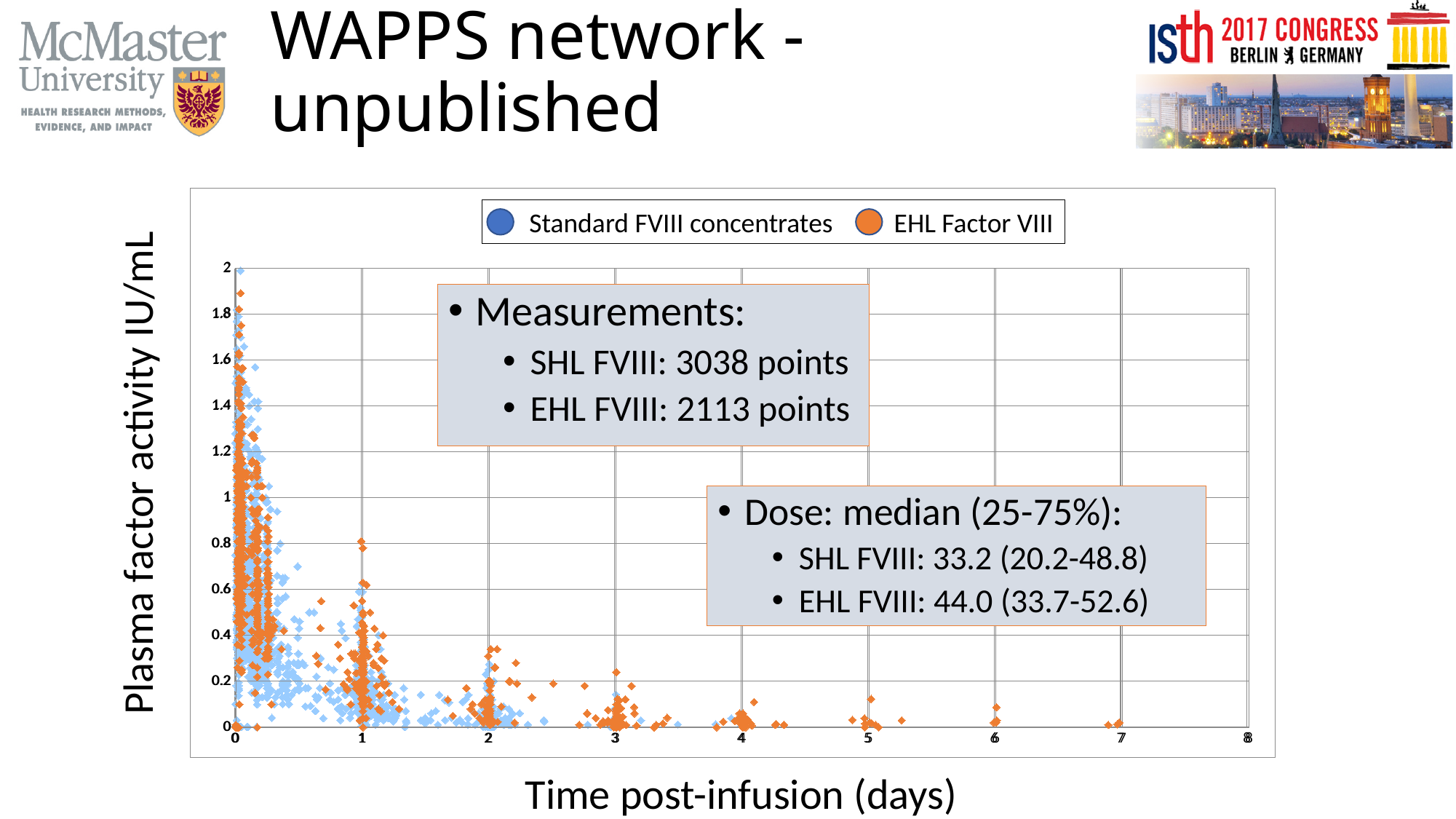
What is the median dose for EHL FVIII shown on the chart? 44.0 According to the text box on the chart, how many measurement points are there for EHL FVIII? 2113 points Do the plotted plasma factor activity values generally rise or fall as time post-infusion increases? Fall How many more measurement points does SHL FVIII have than EHL FVIII? 925 Which series has points plotted at times later than 5 days post-infusion? EHL Factor VIII Which has more measurement points, SHL FVIII or EHL FVIII? SHL FVIII What are the two series named in the chart legend? Standard FVIII concentrates and EHL Factor VIII What kind of chart is shown on the slide? Scatter chart What is the median dose for SHL FVIII shown on the chart? 33.2 How many series does the chart legend list? 2 According to the text box on the chart, how many measurement points are there for SHL FVIII? 3038 points What is the title of the x axis of the chart? Time post-infusion (days)